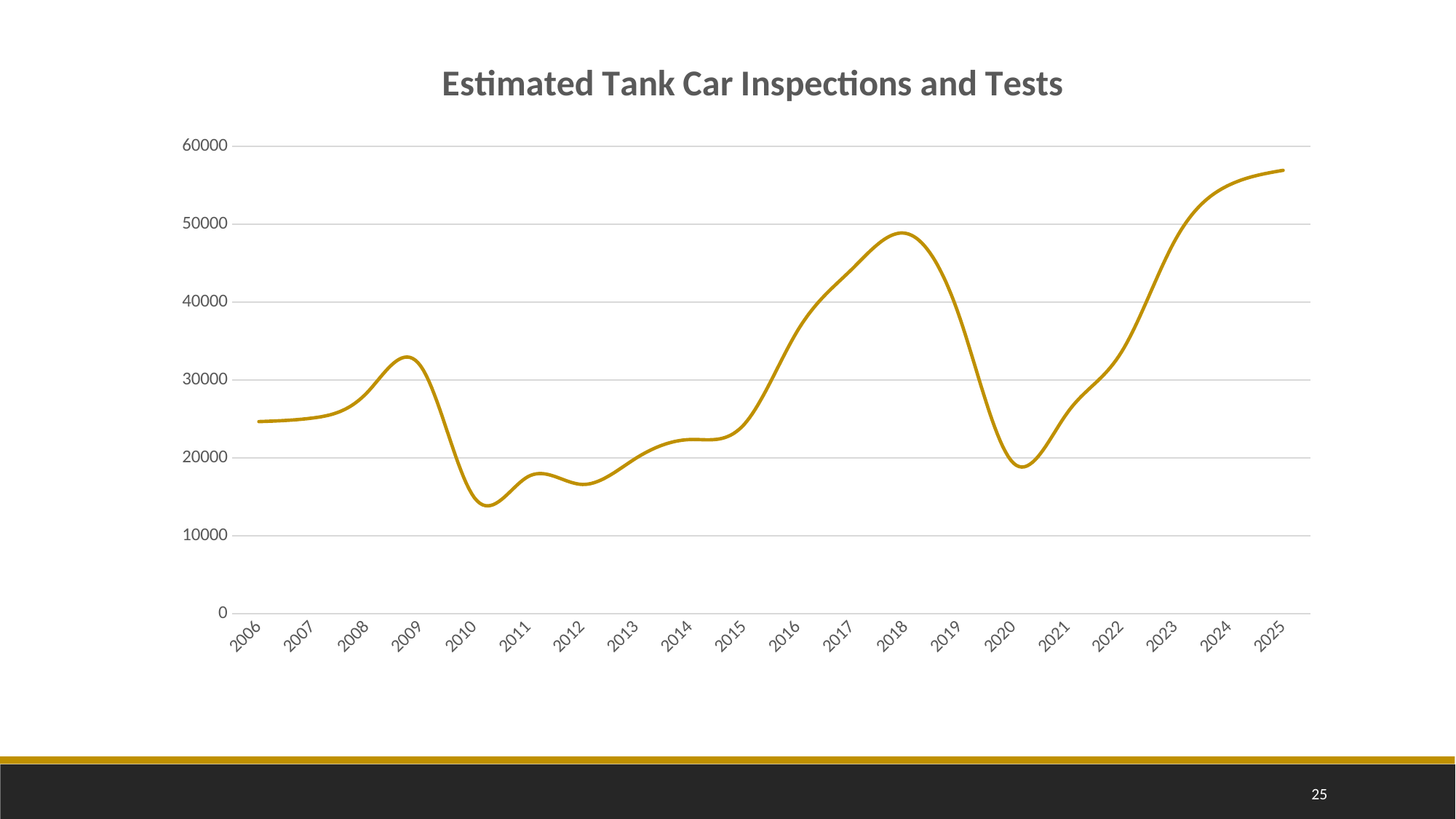
Do the values rise or fall from 2020 to 2025? rise Is the value for 2024 greater or less than 50000? greater Which year has the lowest value? 2010 What is the title of the chart? Estimated Tank Car Inspections and Tests Which is larger, the value for 2018 or the value for 2009? 2018 Is the value for 2012 greater or less than 20000? less Is the value for 2020 greater or less than 30000? less Which year has the highest value? 2025 How many years are plotted along the x axis? 20 Do the values rise or fall from 2018 to 2020? fall What kind of chart is shown on the slide? line chart